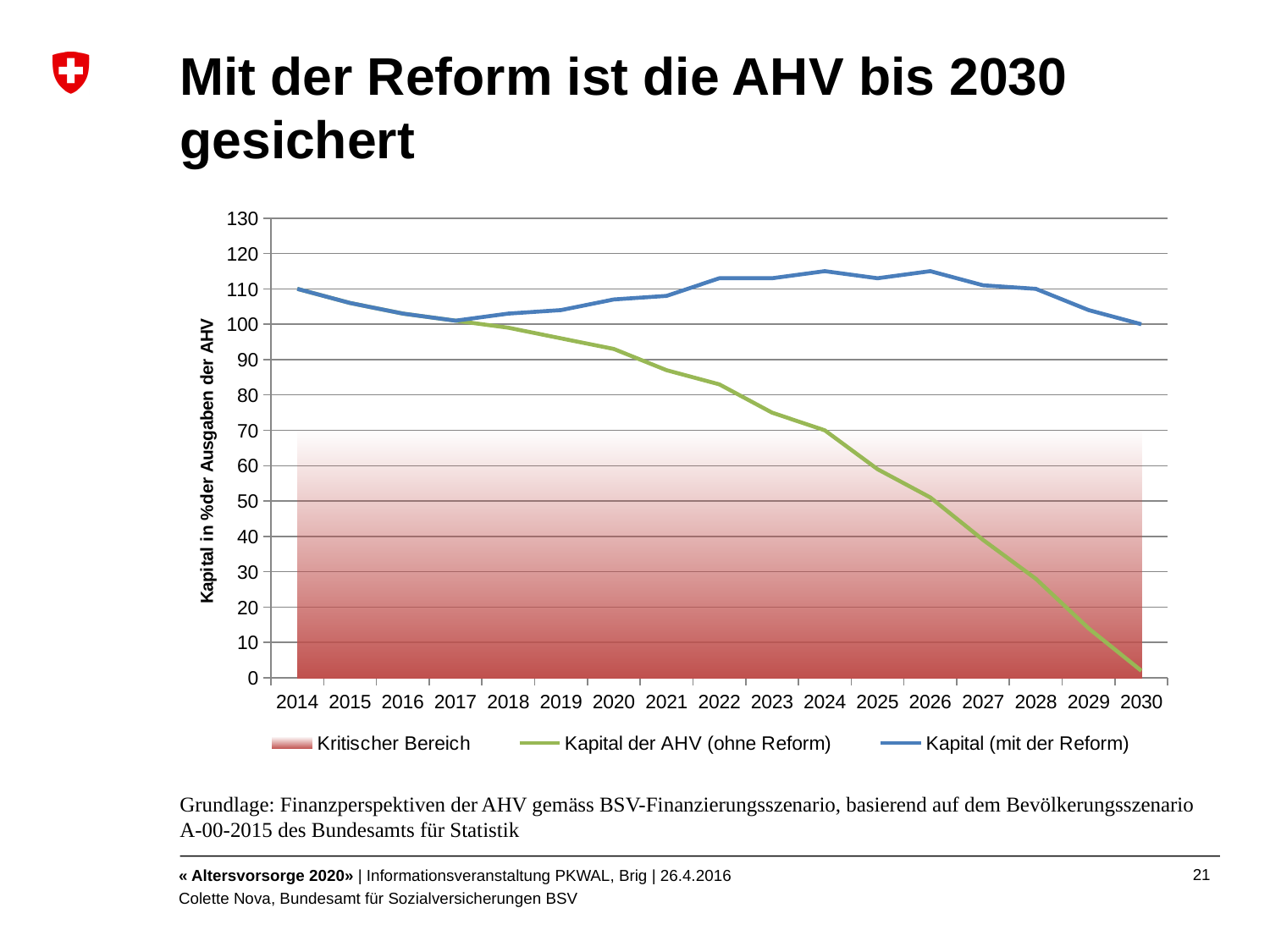
Does the 'Kapital der AHV (ohne Reform)' line rise or fall from 2017 to 2030? fall How many years are shown on the x axis of the chart? 17 What is the value for 'Kapital (mit der Reform)' in 2014? 110 What kind of chart is shown on the slide? line chart What is the label of the y axis of the chart? Kapital in % der Ausgaben der AHV Is the value for 'Kapital (mit der Reform)' in 2026 greater or less than 110? greater Is the value for 'Kapital (mit der Reform)' in 2017 greater or less than 110? less In which year does the 'Kapital der AHV (ohne Reform)' line reach its lowest value? 2030 Is the value for 'Kapital der AHV (ohne Reform)' in 2023 greater or less than 80? less In 2025, which series has the larger value: 'Kapital (mit der Reform)' or 'Kapital der AHV (ohne Reform)'? Kapital (mit der Reform) How many entries does the chart legend list? 3